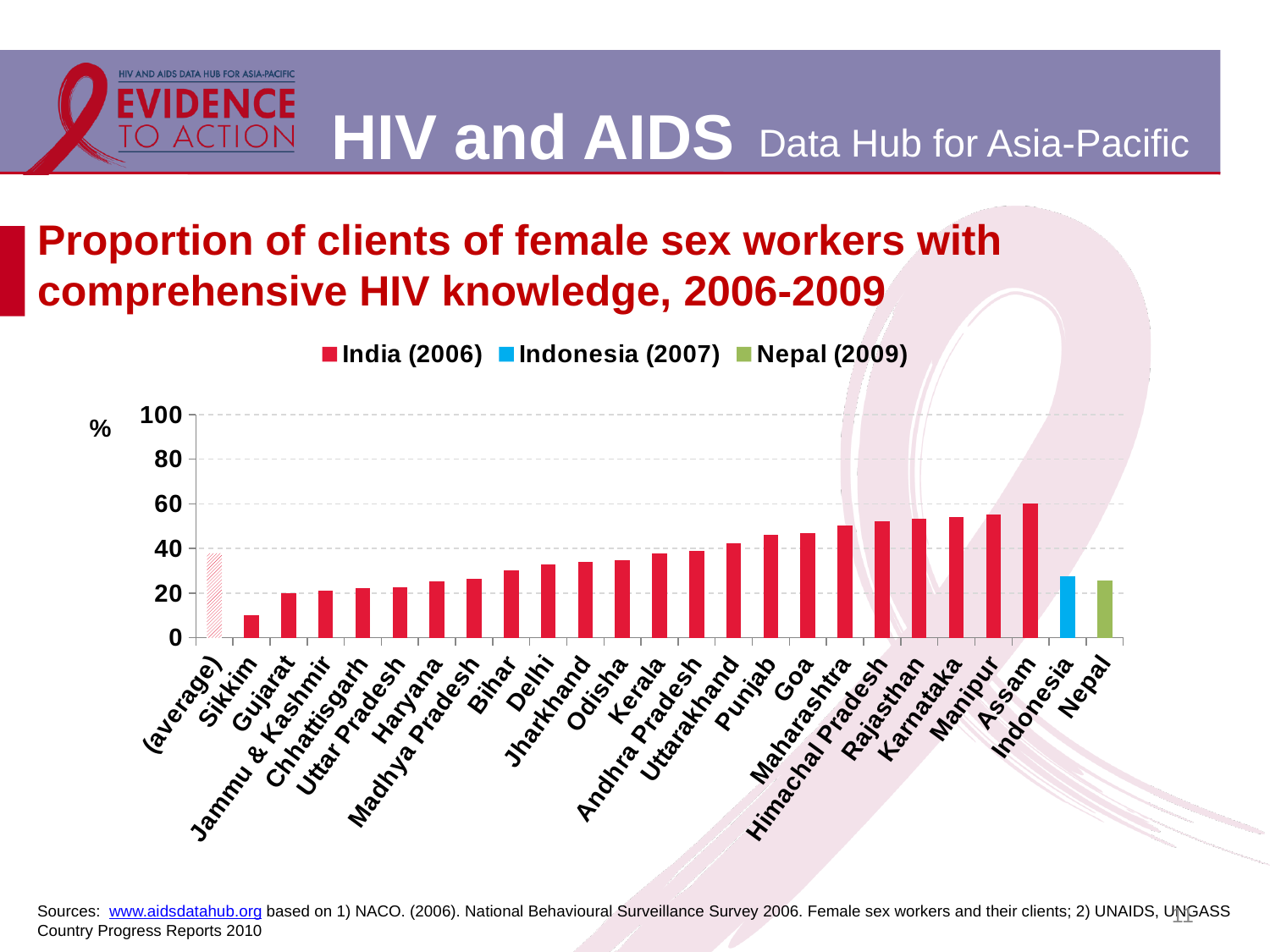
What kind of chart is shown on the slide? bar chart How many series does the legend list? 3 Which is larger, the value for Maharashtra or the value for Bihar? Maharashtra Is the value for Maharashtra greater or less than 40? greater Is the value for Assam greater or less than 40? greater Which category has the lowest bar? Sikkim Is the value for Sikkim greater or less than 20? less Which series are listed in the legend? India (2006), Indonesia (2007), Nepal (2009) How many categories are shown on the x axis? 25 Which category has the highest bar? Assam Do the values for the Indian states rise or fall from left to right along the x axis? rise